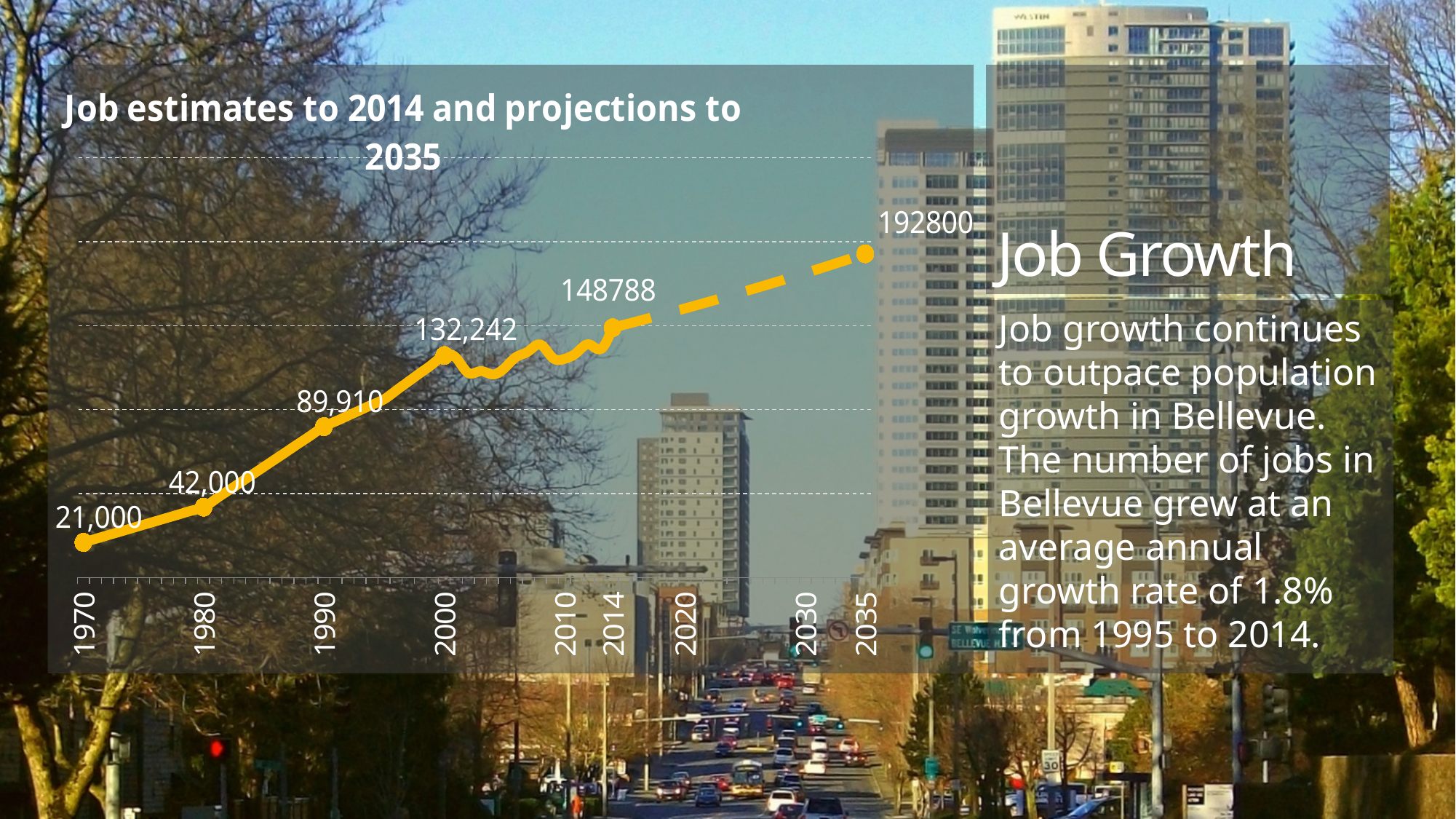
What is the difference between the job values for 1980 and 1970? 21,000 Which labeled year has the lowest job value? 1970 What kind of chart is shown on the slide? Line chart Which labeled year has the highest job value? 2035 What is the job value shown for 1980? 42,000 What is the job value shown for 2014? 148788 What is the difference between the projected 2035 value and the 2014 value? 44012 What is the projected job value shown for 2035? 192800 What is the job value shown for 1990? 89,910 What is the job value shown for 1970? 21,000 What is the job value shown for 2000? 132,242 Do the job values generally rise or fall from 1970 to 2035? Rise